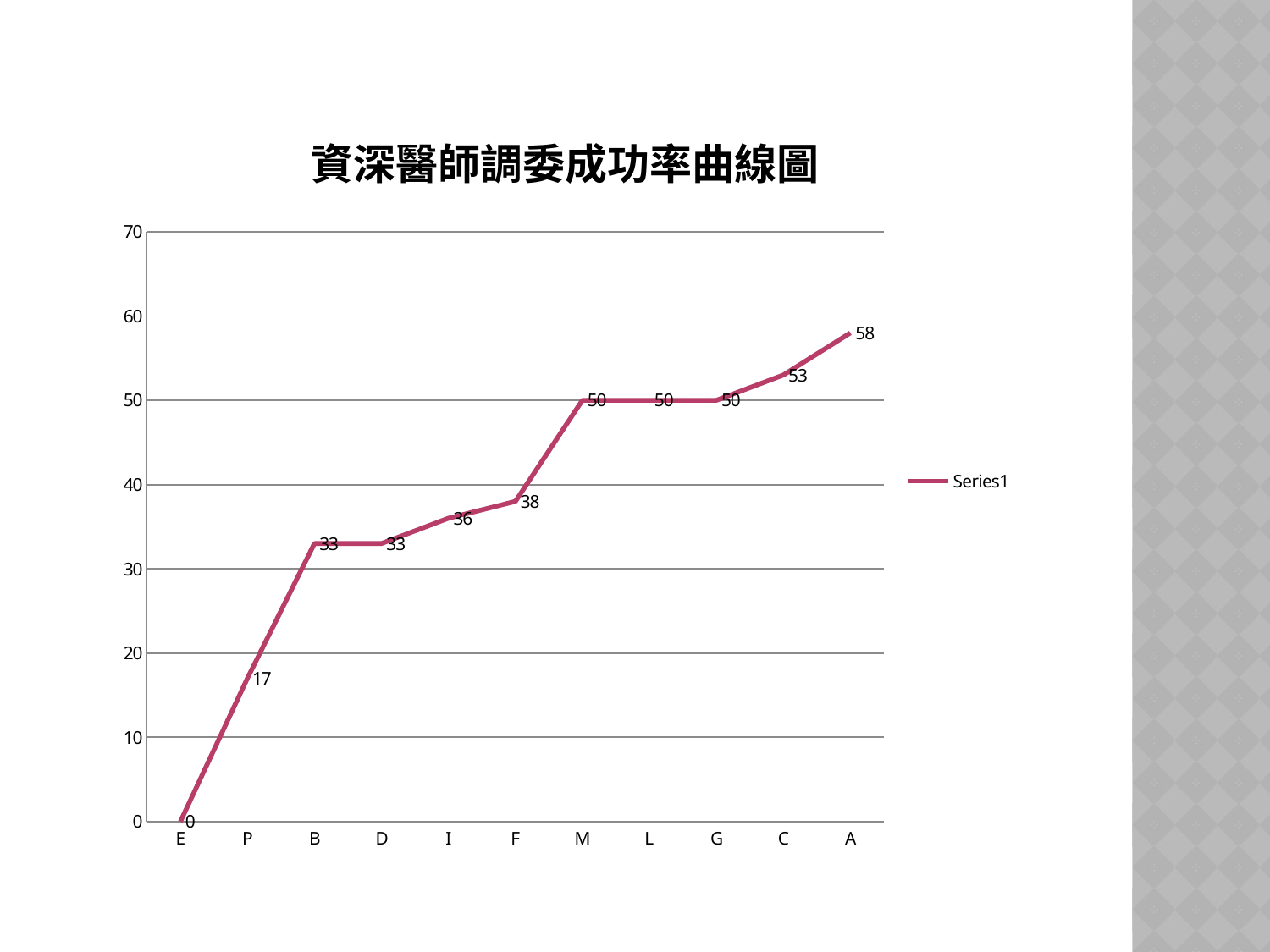
What is the value for category F? 38 What is the value for category A? 58 What is the difference between the values for M and F? 12 Which category has the lowest value? E Which is larger, the value for I or the value for C? C Do the values generally rise or fall from E to A along the x axis? rise Which category has the highest value? A What is the value for category P? 17 How many categories are shown on the x axis? 11 How many series does the legend list? 1 What is the difference between the values for A and C? 5 What kind of chart is shown on the slide? line chart